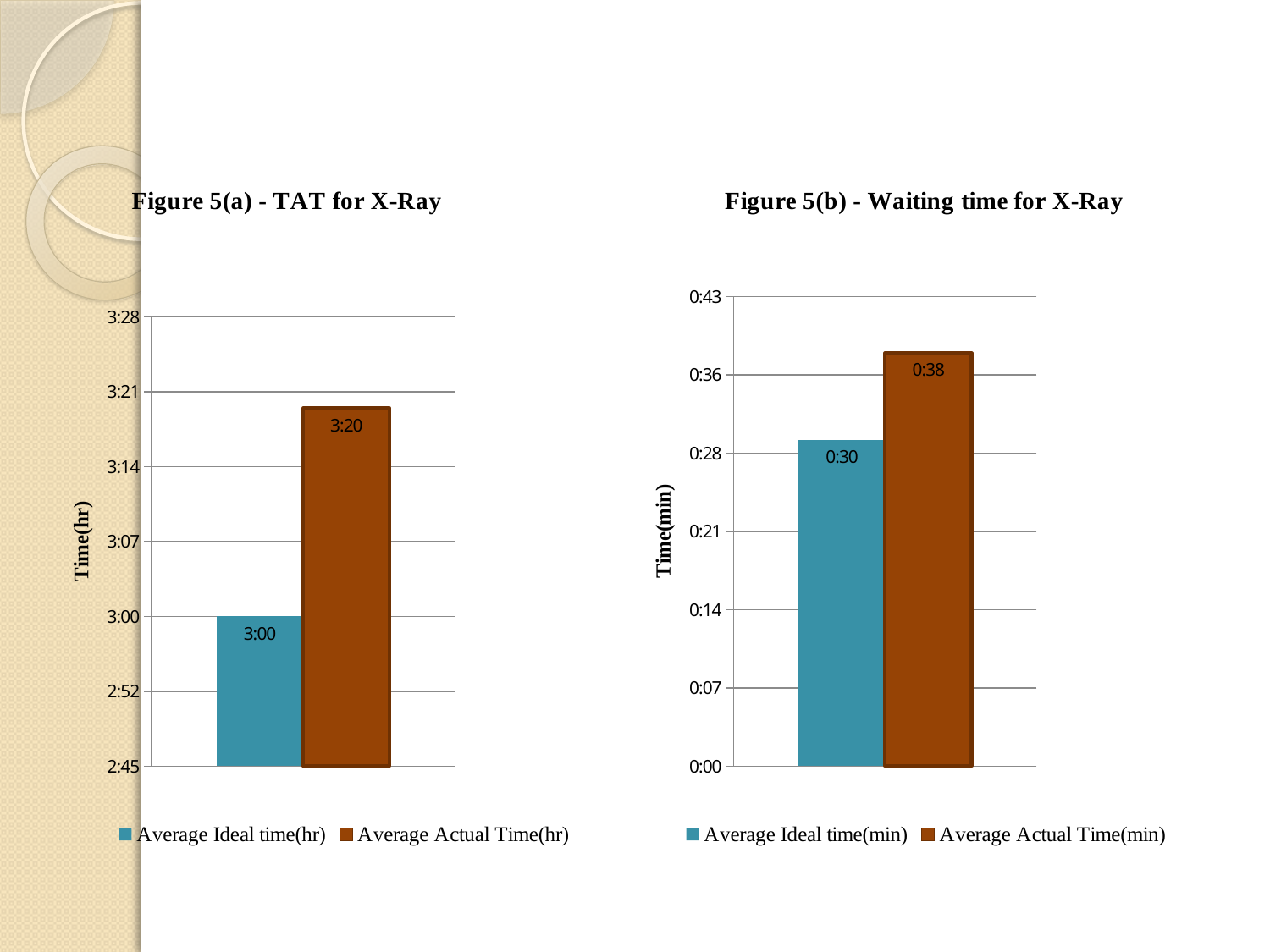
In Figure 5(b) - Waiting time for X-Ray, is Average Actual Time(min) larger or smaller than Average Ideal time(min)? larger What is the y-axis label of Figure 5(b) - Waiting time for X-Ray? Time(min) In Figure 5(b) - Waiting time for X-Ray, what is the value for Average Actual Time(min)? 0:38 In Figure 5(a) - TAT for X-Ray, which series has the higher value? Average Actual Time(hr) In Figure 5(a) - TAT for X-Ray, what is the value for Average Actual Time(hr)? 3:20 What kind of chart is Figure 5(b) - Waiting time for X-Ray? bar chart In Figure 5(b) - Waiting time for X-Ray, is the value for Average Ideal time(min) greater or less than 0:36? less In Figure 5(a) - TAT for X-Ray, is the value for Average Actual Time(hr) greater or less than 3:14? greater In Figure 5(a) - TAT for X-Ray, what is the value for Average Ideal time(hr)? 3:00 In Figure 5(b) - Waiting time for X-Ray, what is the value for Average Ideal time(min)? 0:30 In Figure 5(a) - TAT for X-Ray, how many series does the legend list? 2 In Figure 5(b) - Waiting time for X-Ray, which series has the lower value? Average Ideal time(min)